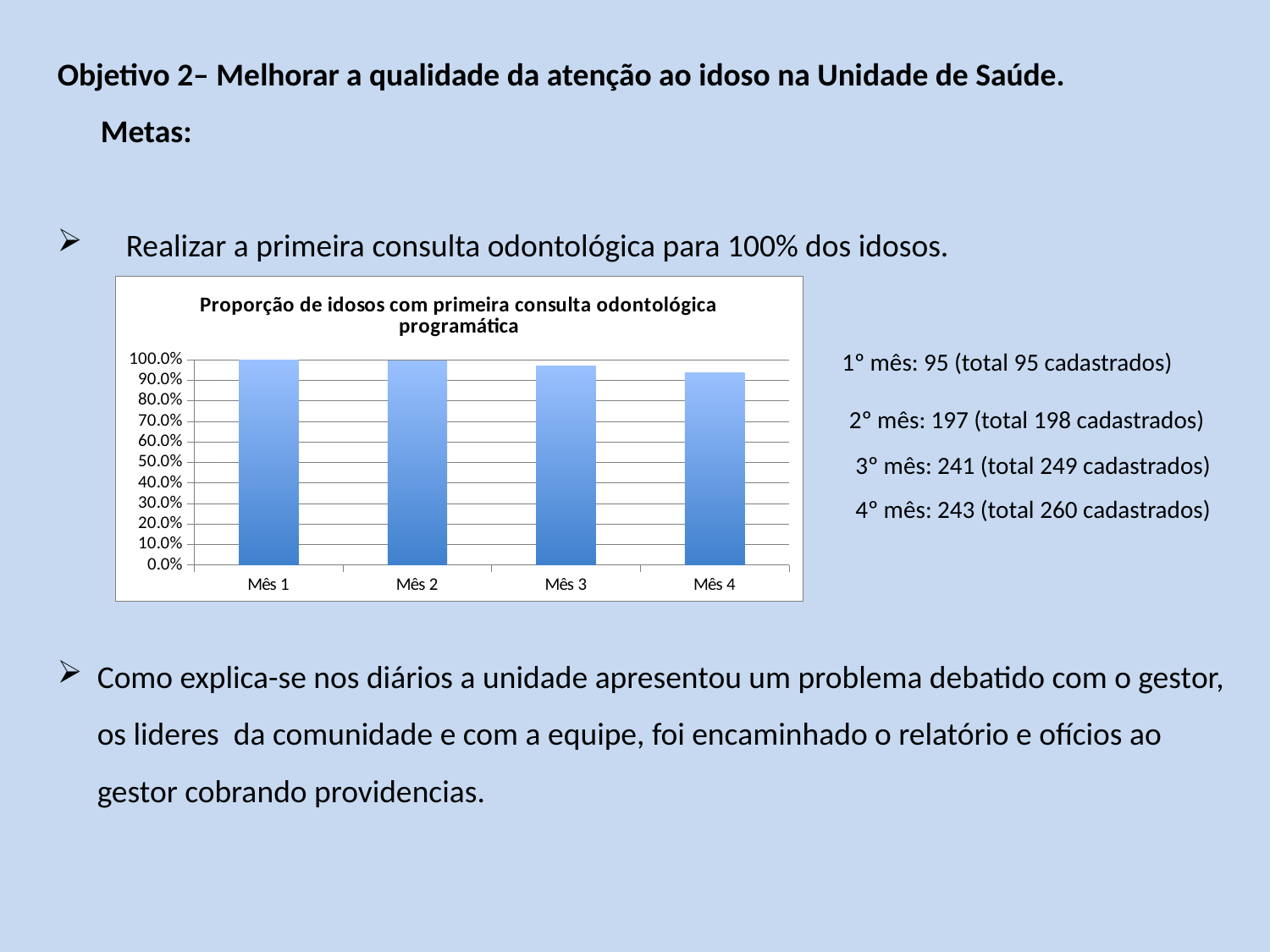
What kind of chart is shown on the slide? bar chart Do the values in the chart generally rise or fall from Mês 1 to Mês 4? fall Is the value for Mês 4 greater or less than 100.0%? less Is the value for Mês 4 greater or less than 90.0%? greater What is the value for Mês 1 in the chart? 100.0% What is the title of the chart? Proporção de idosos com primeira consulta odontológica programática How many months (categories) are plotted in the chart? 4 What colour are the bars in the chart? blue Which is larger in the chart, the value for Mês 3 or the value for Mês 4? Mês 3 Which is larger in the chart, the value for Mês 1 or the value for Mês 4? Mês 1 Is the value for Mês 3 greater or less than 90.0%? greater Which month has the lowest value in the chart? Mês 4